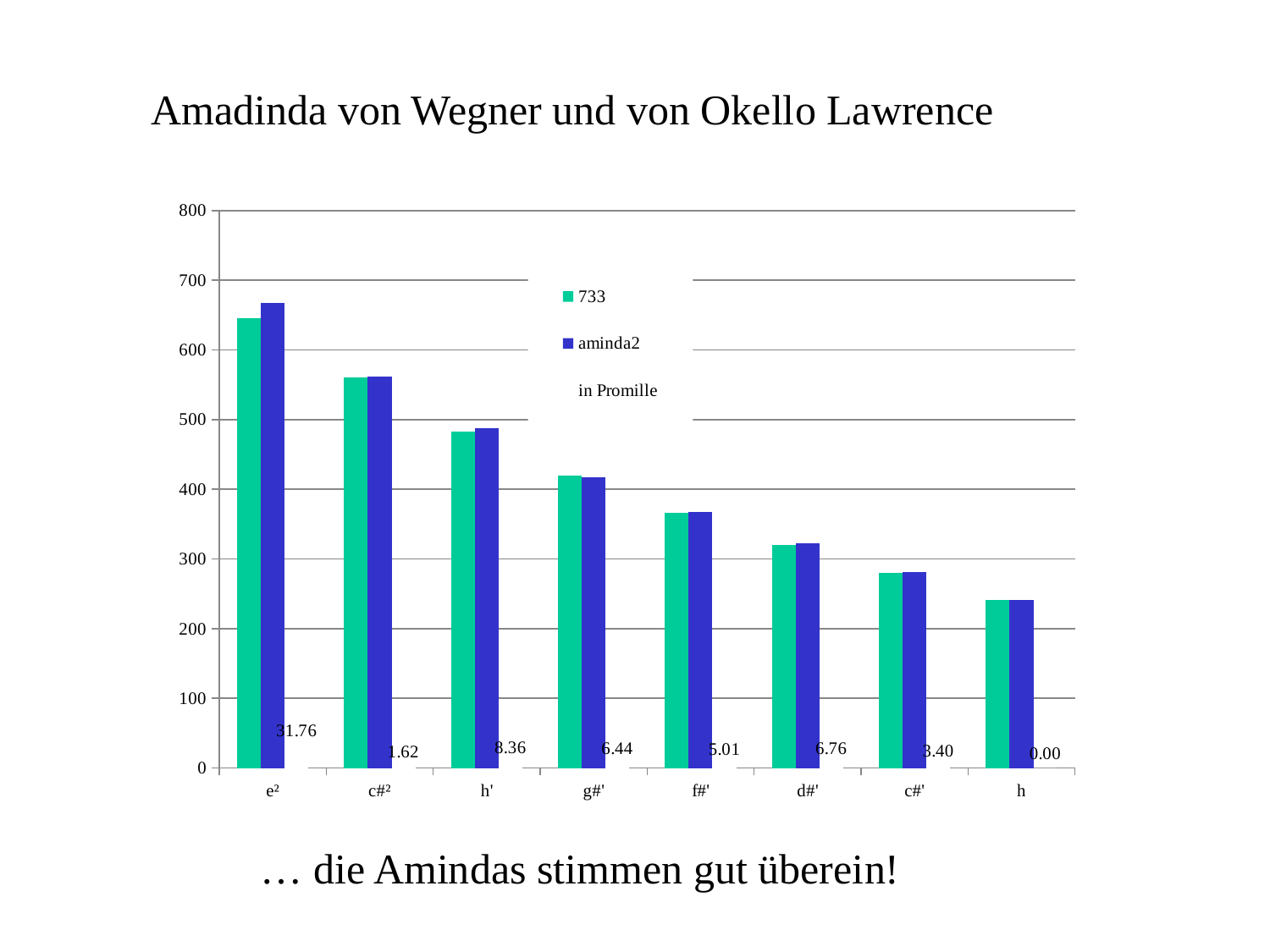
Which category has the lowest bars? h Do the bar heights rise or fall from left to right along the x axis? fall Is the value of the aminda2 series for c#² greater or less than 500? greater Is the value of the 733 series for e² greater or less than 600? greater What kind of chart is shown on the slide? bar chart How many categories are shown along the x axis? 8 Is the value of the 733 series for f#' greater or less than 400? less Which category has the highest bars? e² What data label is printed at the base of the bars for e²? 31.76 What is the title of the slide above the chart? Amadinda von Wegner und von Okello Lawrence Which is larger, the 733 value for e² or the 733 value for h? e²